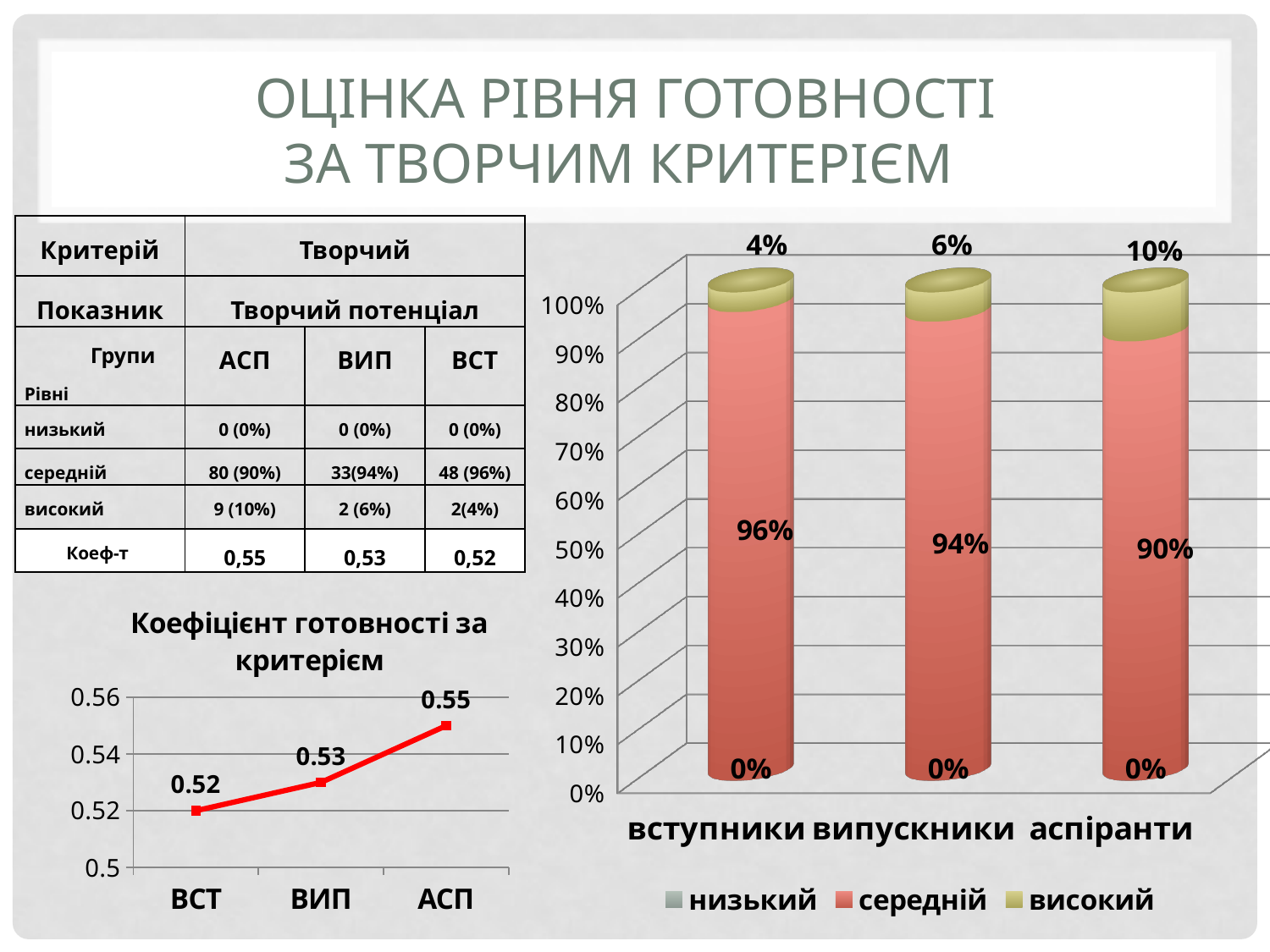
In the stacked bar chart on the right, what is the value of 'високий' for аспіранти? 10% In the line chart 'Коефіцієнт готовності за критерієм', how many groups are plotted on the x axis? 3 In the stacked bar chart on the right, is the 'середній' value larger for випускники or аспіранти? випускники In the line chart 'Коефіцієнт готовності за критерієм', which group has the lowest value? ВСТ In the stacked bar chart on the right, what is the value of 'середній' for вступники? 96% In the stacked bar chart on the right, which category has the highest 'високий' value? аспіранти In the stacked bar chart on the right, how many series does the legend list? 3 What kind of chart is the chart on the right side of the slide? stacked bar chart In the line chart 'Коефіцієнт готовності за критерієм', which group has the highest value? АСП In the line chart 'Коефіцієнт готовності за критерієм', do the values rise or fall from ВСТ to АСП? rise In the line chart 'Коефіцієнт готовності за критерієм', what is the difference between the values for АСП and ВСТ? 0.03 In the line chart 'Коефіцієнт готовності за критерієм', what is the value for ВИП? 0.53